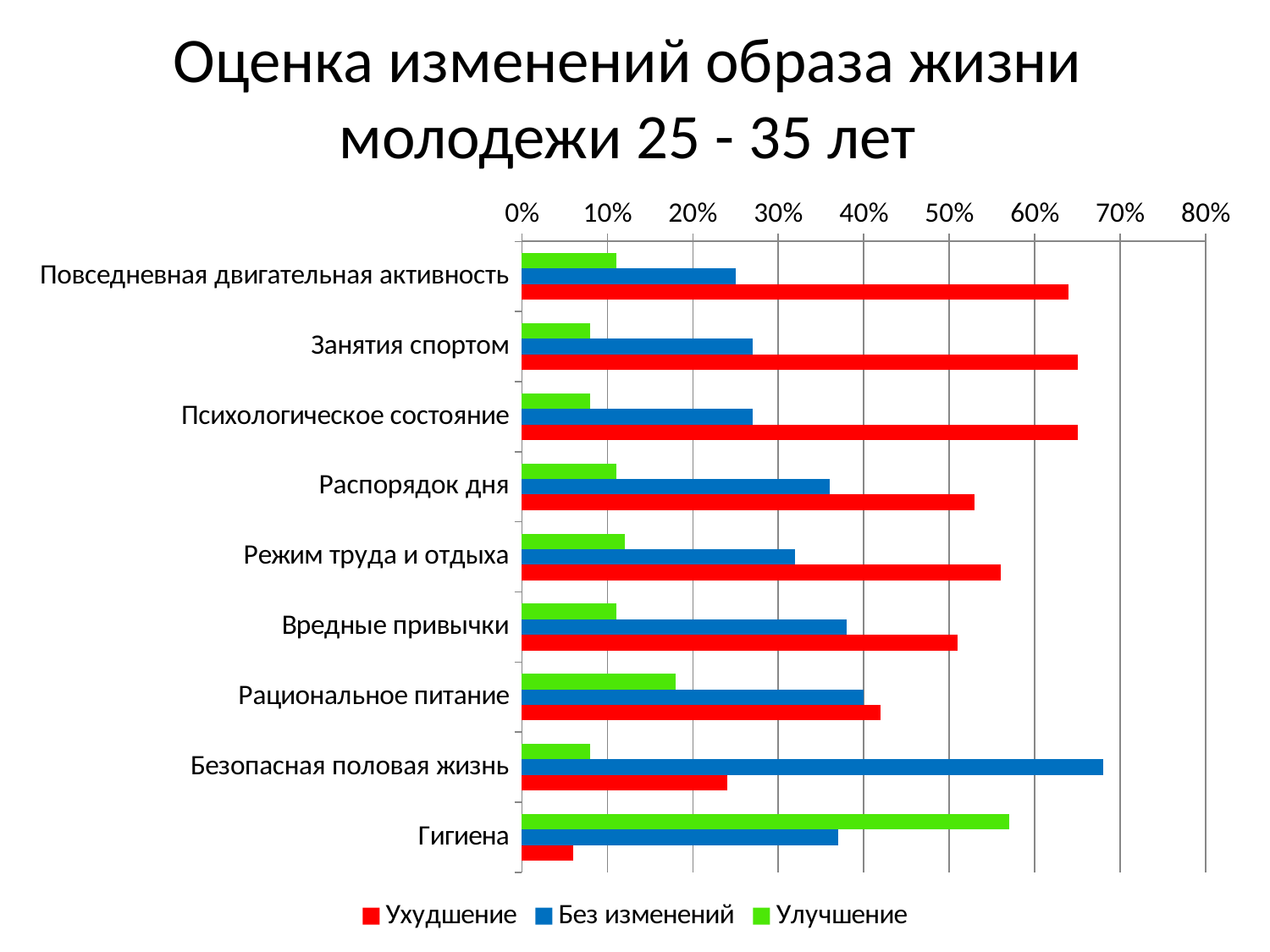
How many categories are shown on the chart? 9 What kind of chart is shown on the slide? bar chart How many series does the legend list? 3 Which category has the lowest value for Ухудшение? Гигиена Is the Улучшение value for Рациональное питание greater or less than 20%? less Is the Без изменений value for Безопасная половая жизнь greater or less than 60%? greater For Безопасная половая жизнь, which is larger: Ухудшение or Без изменений? Без изменений What is the title of the chart? Оценка изменений образа жизни молодежи 25 - 35 лет Is the Ухудшение value for Повседневная двигательная активность greater or less than 60%? greater Which category has the highest value for Без изменений? Безопасная половая жизнь Which category has the highest value for Улучшение? Гигиена